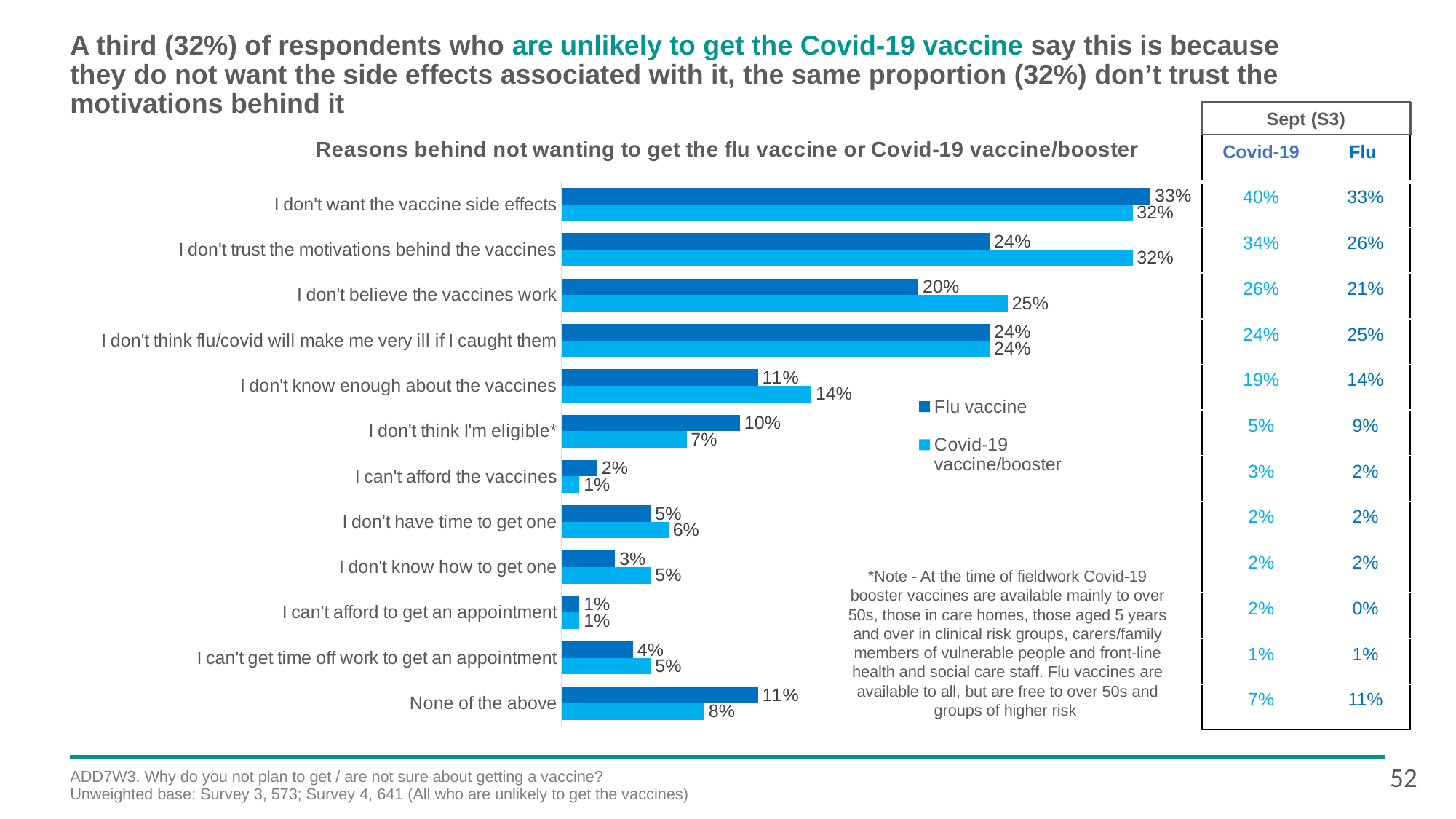
For "None of the above", which series has the larger value, Flu vaccine or Covid-19 vaccine/booster? Flu vaccine Which reason has the highest Flu vaccine value? I don't want the vaccine side effects What type of chart is shown on the slide? Bar chart What is the Covid-19 vaccine/booster value for "I don't know enough about the vaccines"? 14% What is the title of the chart? Reasons behind not wanting to get the flu vaccine or Covid-19 vaccine/booster How many reason categories are plotted in the chart? 12 For "I don't think I'm eligible*", which series has the larger value, Flu vaccine or Covid-19 vaccine/booster? Flu vaccine How many series does the chart legend list? 2 What is the difference between the Covid-19 vaccine/booster and Flu vaccine values for "I don't trust the motivations behind the vaccines"? 8% What is the Covid-19 vaccine/booster value for "I don't trust the motivations behind the vaccines"? 32% What is the Flu vaccine value for "I don't believe the vaccines work"? 20% Which reason has the lowest Flu vaccine value? I can't afford to get an appointment